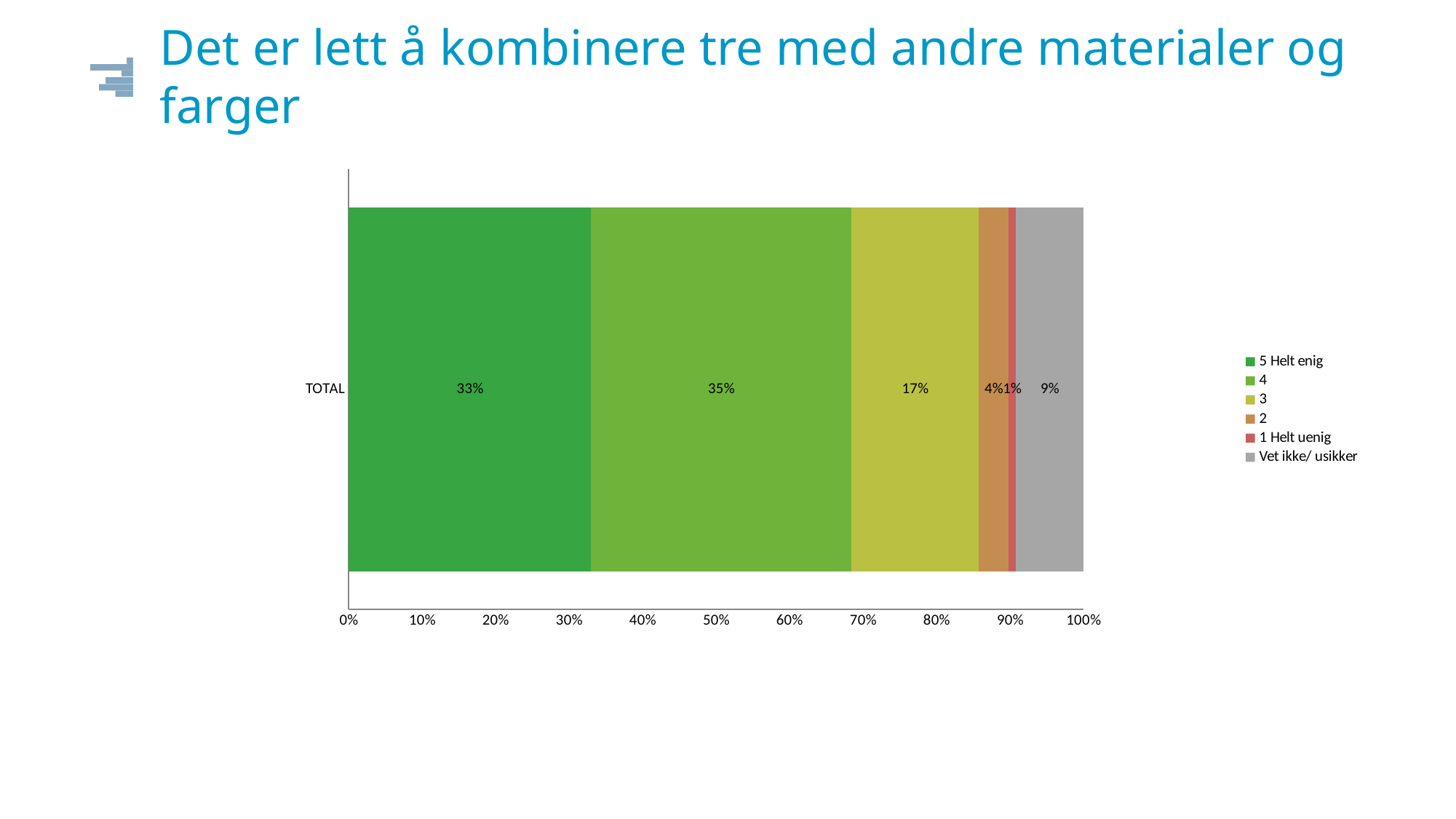
Which series has the smallest share of the TOTAL bar? 1 Helt uenig What is the combined share of '5 Helt enig' and '4'? 68% What kind of chart is shown on the slide? Stacked bar chart What is the difference between the '4' share and the '5 Helt enig' share? 2% Which is larger, the share for '3' or the share for 'Vet ikke/ usikker'? 3 What percentage of the TOTAL bar is 'Vet ikke/ usikker'? 9% How many series does the legend list? 6 What percentage of the TOTAL bar is '5 Helt enig'? 33% What percentage of the TOTAL bar is the series '3'? 17% What percentage of the TOTAL bar is the series '4'? 35% What percentage of the TOTAL bar is '1 Helt uenig'? 1% Which series has the largest share of the TOTAL bar? 4